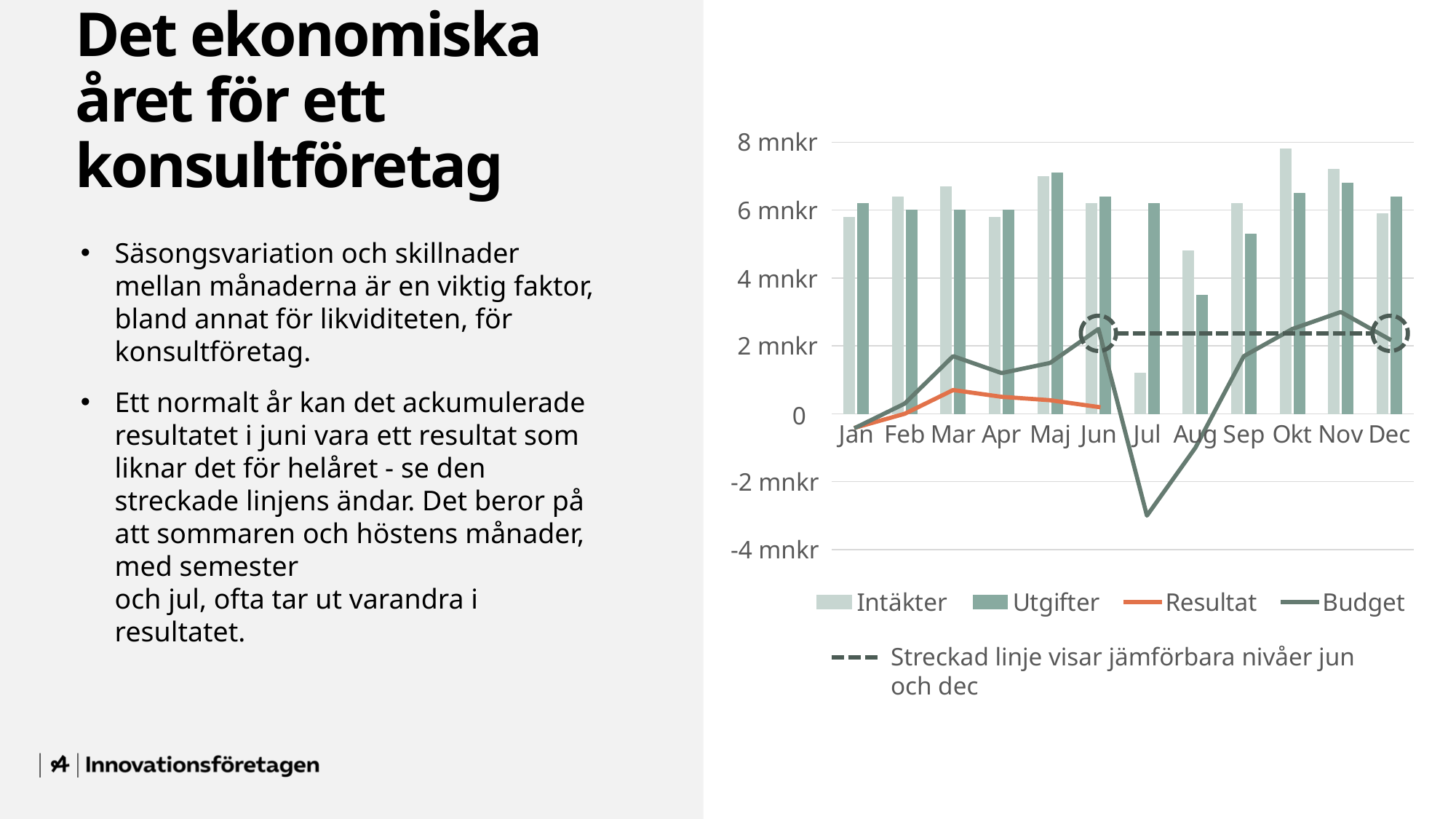
In which month does the Budget line reach its lowest point? Jul Does the Budget line rise or fall from Jun to Jul? Fall In Aug, which is larger: Intäkter or Utgifter? Intäkter Is the value of Intäkter in Okt greater or less than 6 mnkr? greater How many entries does the chart legend list? 5 Is the Budget value in Jul greater or less than -2 mnkr? less In which month is Intäkter highest? Okt In which month is Intäkter lowest? Jul In which month is Utgifter lowest? Aug How many months are shown on the x axis of the chart? 12 Is the value of Utgifter in Aug greater or less than 4 mnkr? less What type of chart is shown on the slide? Combined bar and line chart